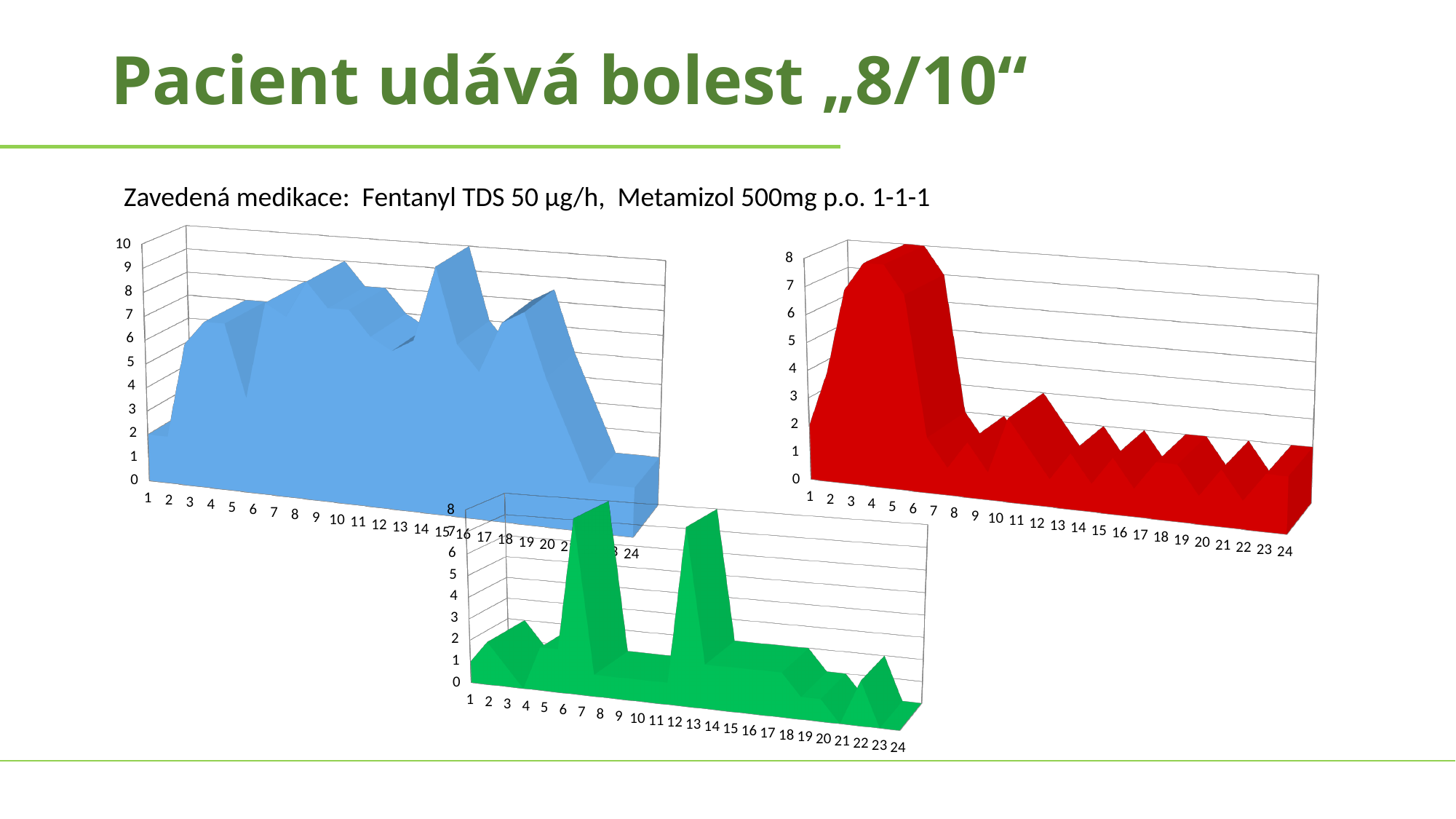
What kind of chart is the top-left (blue) chart? area chart In the top-right (red) chart, do the values generally rise or fall from point 6 to point 24? fall In the top-left (blue) chart, is the value at point 1 greater or less than 5? less In the bottom (green) chart, is the value at point 1 greater or less than 4? less How many points are plotted along the x axis of the bottom (green) chart? 24 In the bottom (green) chart, is the value at point 7 greater or less than 4? greater How many points are plotted along the x axis of the top-right (red) chart? 24 What is the highest value shown on the y axis of the top-left (blue) chart? 10